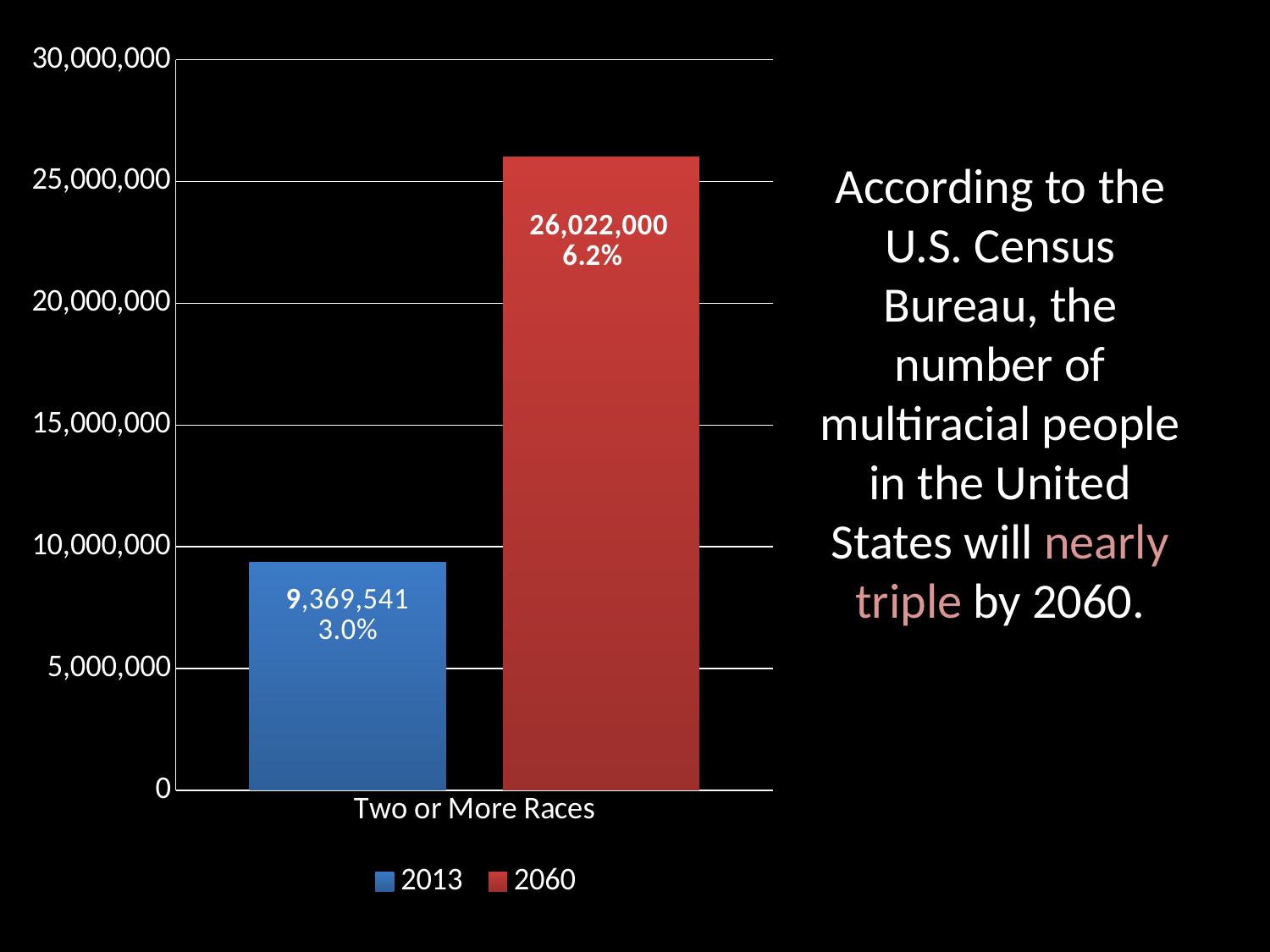
What percentage is shown on the 2060 bar? 6.2% How many series does the legend list? 2 Is the value for 2013 greater or less than 10,000,000? less Is the value for 2060 greater or less than 25,000,000? greater Which series has the higher value for Two or More Races, 2013 or 2060? 2060 What percentage is shown on the 2013 bar? 3.0% What is the difference between the 2060 value and the 2013 value? 16,652,459 What is the value for 2060 for Two or More Races? 26,022,000 What is the value for 2013 for Two or More Races? 9,369,541 What kind of chart is shown on the slide? bar chart What is the category label on the x axis? Two or More Races Which series has the lowest value on the chart? 2013